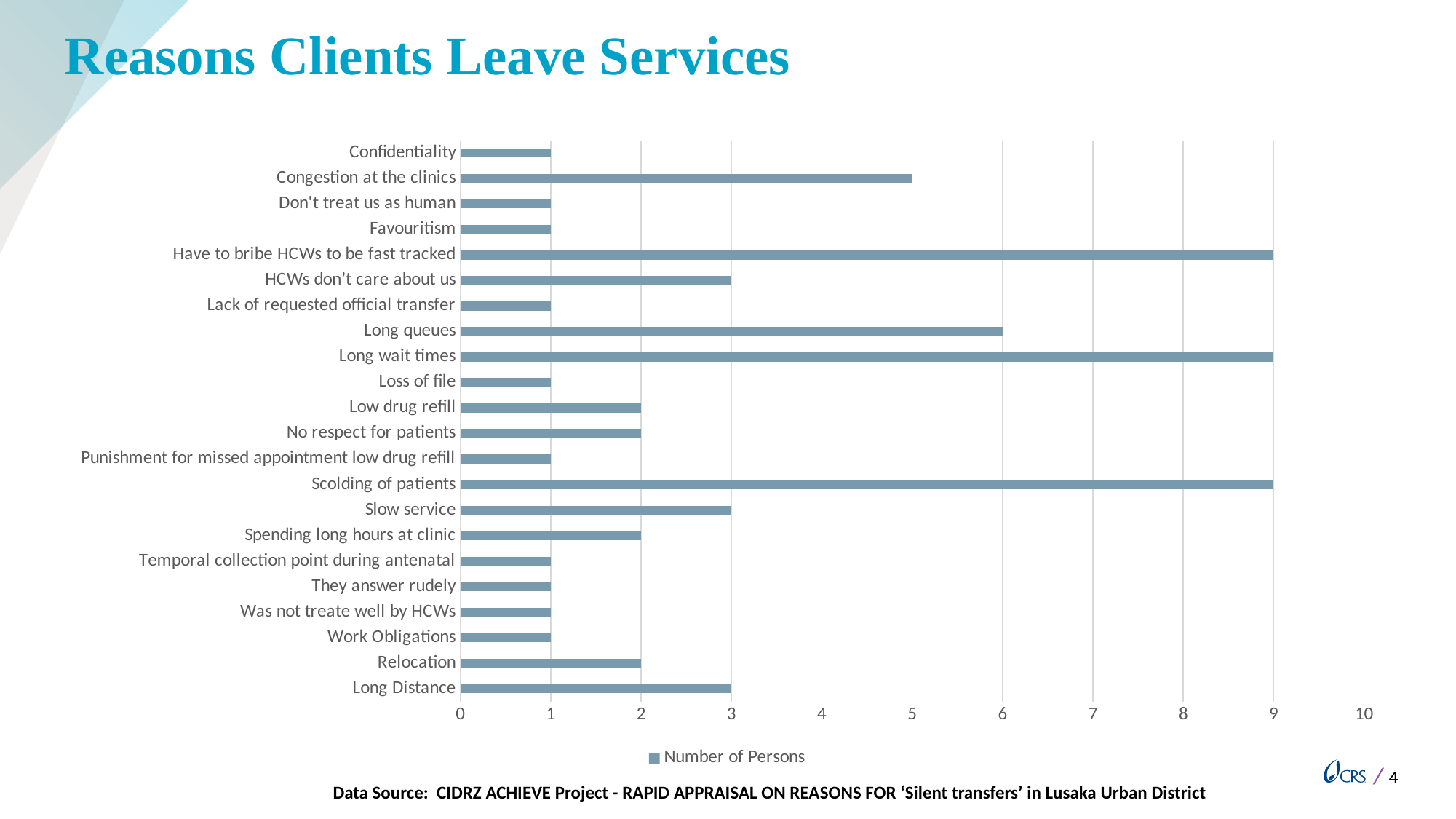
How many persons cited 'Have to bribe HCWs to be fast tracked'? 9 What is the value for 'Long Distance'? 3 How many reasons (categories) are listed on the chart? 22 Which has a larger value, 'Long queues' or 'Congestion at the clinics'? Long queues What is the value for 'Relocation'? 2 How many series does the legend list? 1 Which has a larger value, 'HCWs don't care about us' or 'Low drug refill'? HCWs don't care about us What is the value for 'Long queues'? 6 What type of chart is shown on the slide? Bar chart What is the difference between the values for 'Congestion at the clinics' and 'Slow service'? 2 What is the difference between the values for 'Long wait times' and 'Long queues'? 3 How many persons cited 'Congestion at the clinics' as a reason? 5